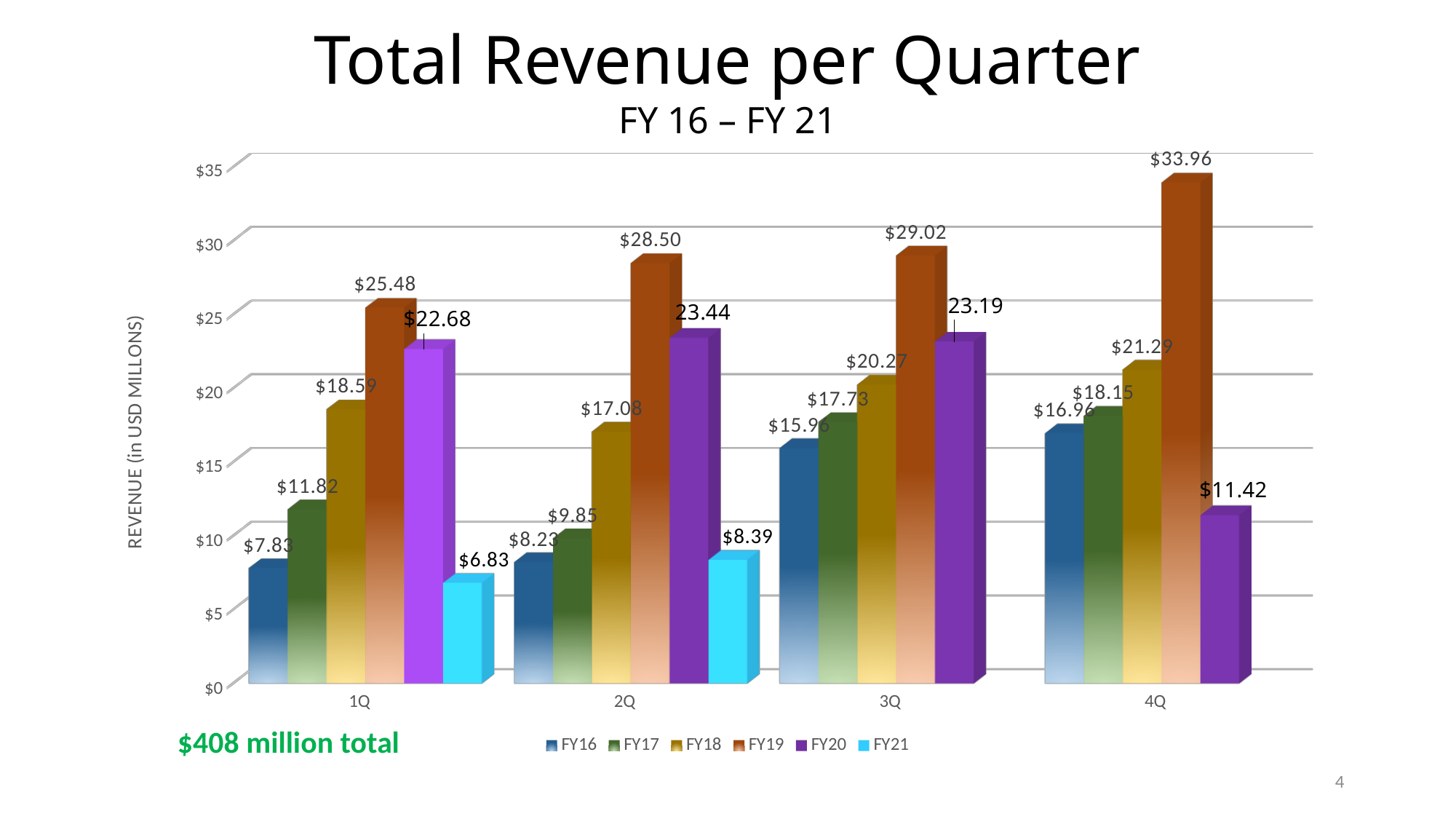
What kind of chart is shown on the slide? Bar chart How many fiscal years does the legend list? 6 What is the FY19 revenue in 4Q? $33.96 What is the FY20 revenue in 2Q? 23.44 How many quarters are shown on the x axis? 4 What is the difference between FY17 and FY16 revenue in 1Q? $3.99 How much higher is FY19 revenue in 4Q than in 3Q? $4.94 What is the FY21 revenue in 1Q? $6.83 In which quarter is FY20 revenue lowest? 4Q Does FY16 revenue rise or fall from 1Q to 4Q? Rise Which is larger: FY18 revenue in 3Q or FY17 revenue in 4Q? FY18 revenue in 3Q In which quarter is FY19 revenue highest? 4Q